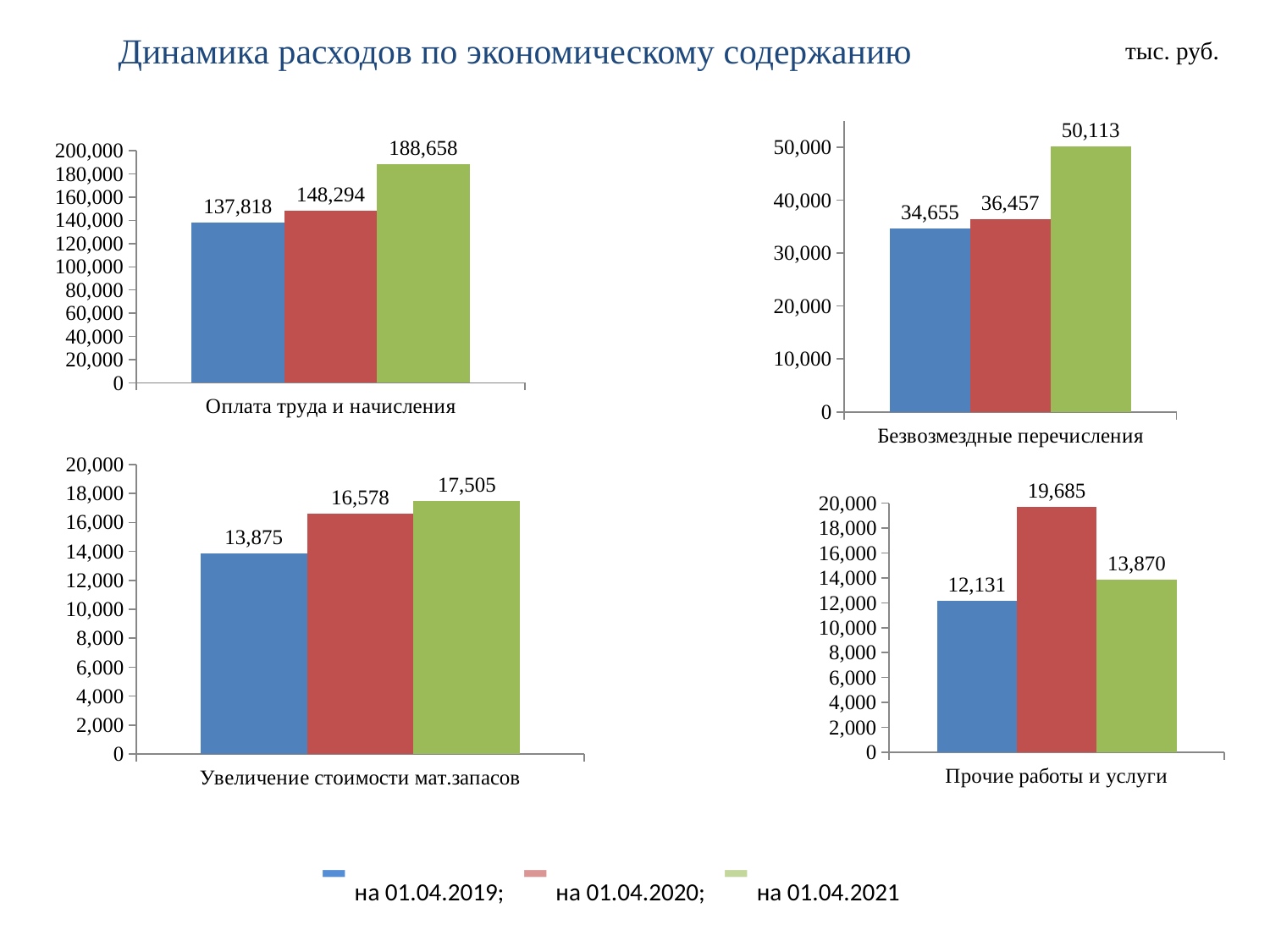
In the chart 'Безвозмездные перечисления', what is the value for на 01.04.2019? 34,655 In the chart 'Увеличение стоимости мат.запасов', what is the value for на 01.04.2020? 16,578 In the chart 'Прочие работы и услуги', which date has the highest value? на 01.04.2020 In the chart 'Безвозмездные перечисления', what is the difference between the values for на 01.04.2021 and на 01.04.2019? 15,458 What unit is stated in the top right corner of the slide? тыс. руб. In the chart 'Оплата труда и начисления', what is the difference between the values for на 01.04.2021 and на 01.04.2019? 50,840 In the chart 'Прочие работы и услуги', which date has the lowest value? на 01.04.2019 What kind of chart is 'Безвозмездные перечисления'? bar chart In the chart 'Прочие работы и услуги', which is larger: the value for на 01.04.2020 or на 01.04.2021? на 01.04.2020 In the chart 'Увеличение стоимости мат.запасов', do the values rise or fall from на 01.04.2019 to на 01.04.2021? rise In the chart 'Оплата труда и начисления', what is the value for на 01.04.2021? 188,658 How many series does the legend at the bottom of the slide list? 3